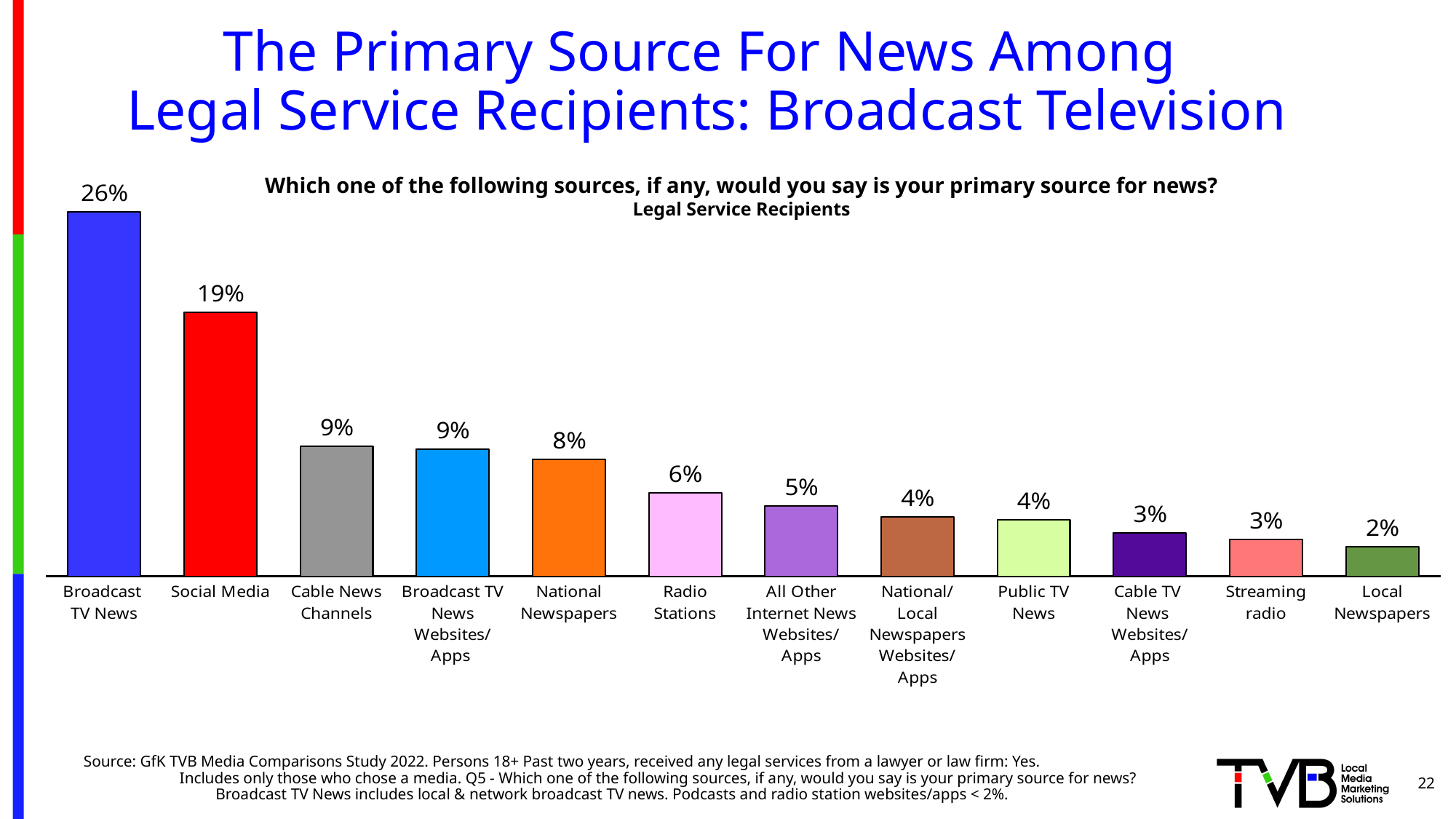
What is the value shown for Radio Stations? 6% What colour is the bar for Social Media? Red Do the values rise or fall moving from left to right along the x axis? Fall What percentage of legal service recipients say Broadcast TV News is their primary source for news? 26% Which is larger, the value for National Newspapers or the value for Radio Stations? National Newspapers What kind of chart is shown on the slide? Bar chart Which source has the highest percentage? Broadcast TV News What is the difference in percentage points between Broadcast TV News and Social Media? 7 What is the value shown for Local Newspapers? 2% How many sources (categories) are shown in the chart? 12 Which source has the lowest percentage? Local Newspapers What is the value shown for Social Media? 19%